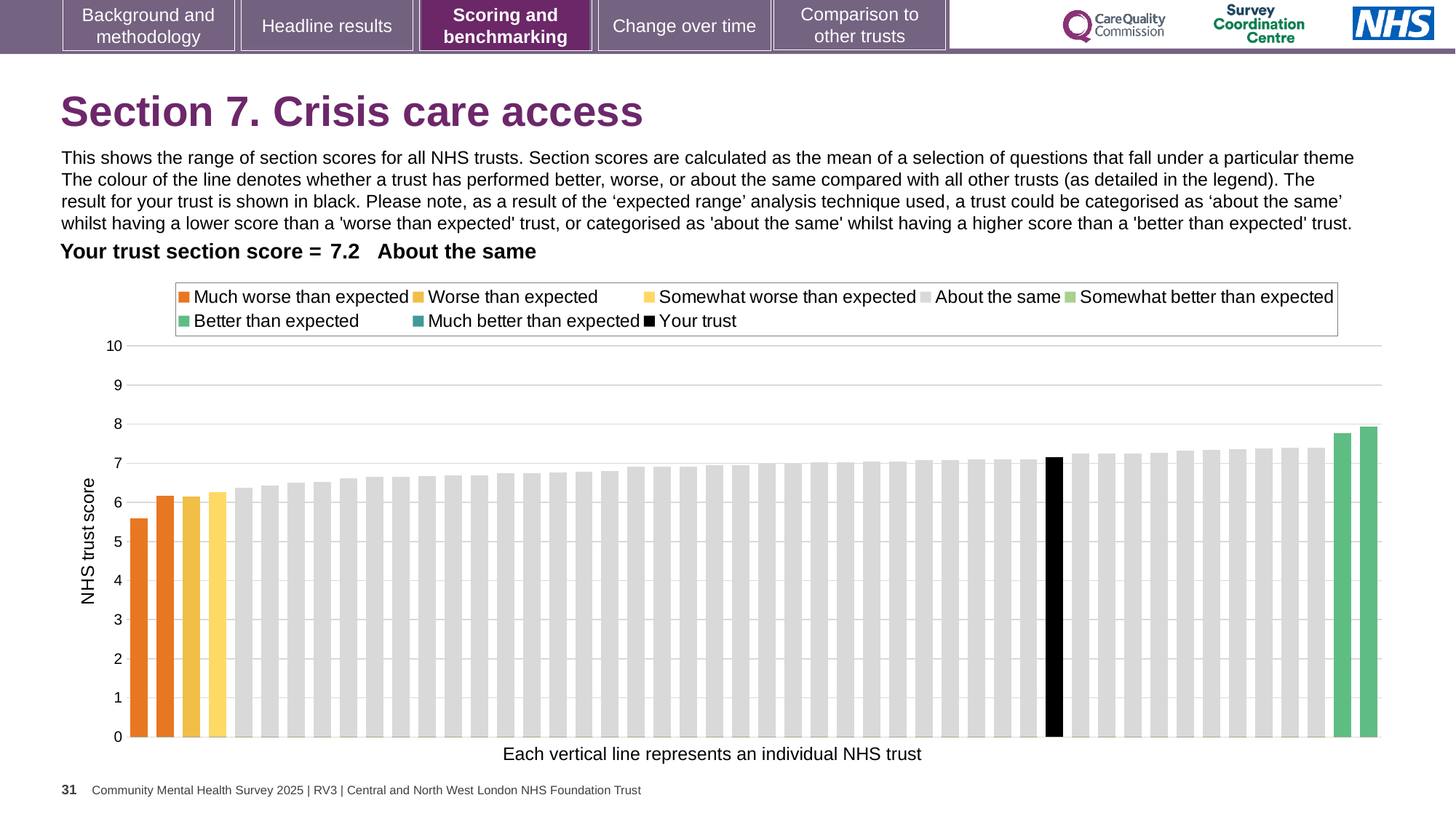
What is the section score for your trust shown on the slide? 7.2 How many entries does the chart legend list? 8 Is the value of the lowest bar (the leftmost orange bar) greater or less than 6? less What is the label on the vertical axis of the chart? NHS trust score Is the value of the black 'Your trust' bar greater or less than 7? greater What kind of chart is shown on the slide? bar chart Which category is your trust placed in for this section? About the same Which is higher: the black 'Your trust' bar or the leftmost orange bar? the black 'Your trust' bar Which legend category do the two highest bars belong to? Better than expected Do the bar values rise or fall from left to right along the x axis? rise